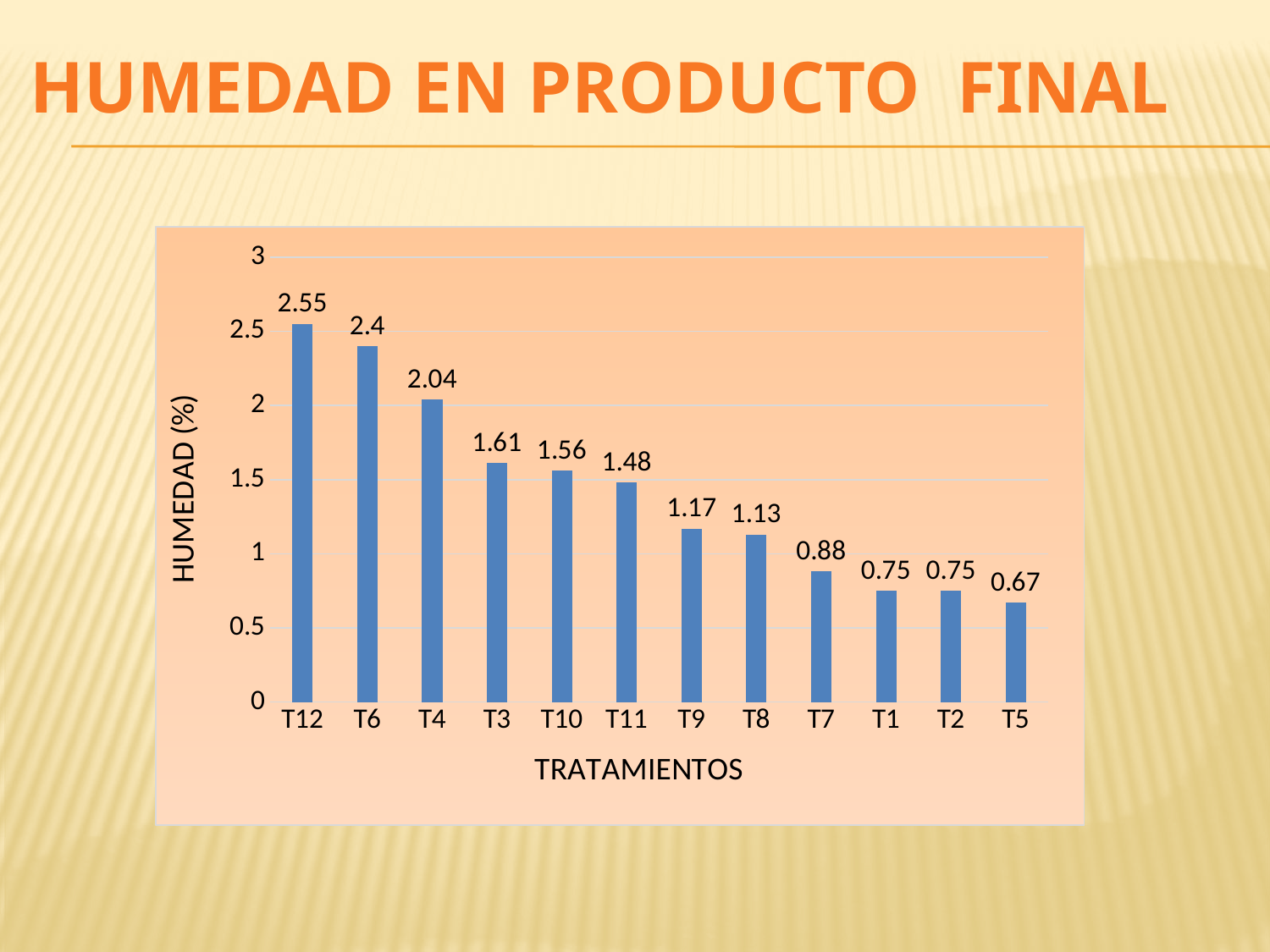
What is the humidity value for T10? 1.56 Which has a higher humidity value, T3 or T9? T3 What kind of chart is shown on the slide? bar chart Which treatment has the lowest humidity? T5 How many treatments are shown on the x axis? 12 Which treatment has the highest humidity? T12 Do the values rise or fall from left to right along the x axis? fall What is the humidity value for T12? 2.55 What is the difference between the humidity values for T6 and T4? 0.36 Is the value for T8 greater or less than 1? greater What is the label of the y axis? HUMEDAD (%) What is the humidity value for T7? 0.88